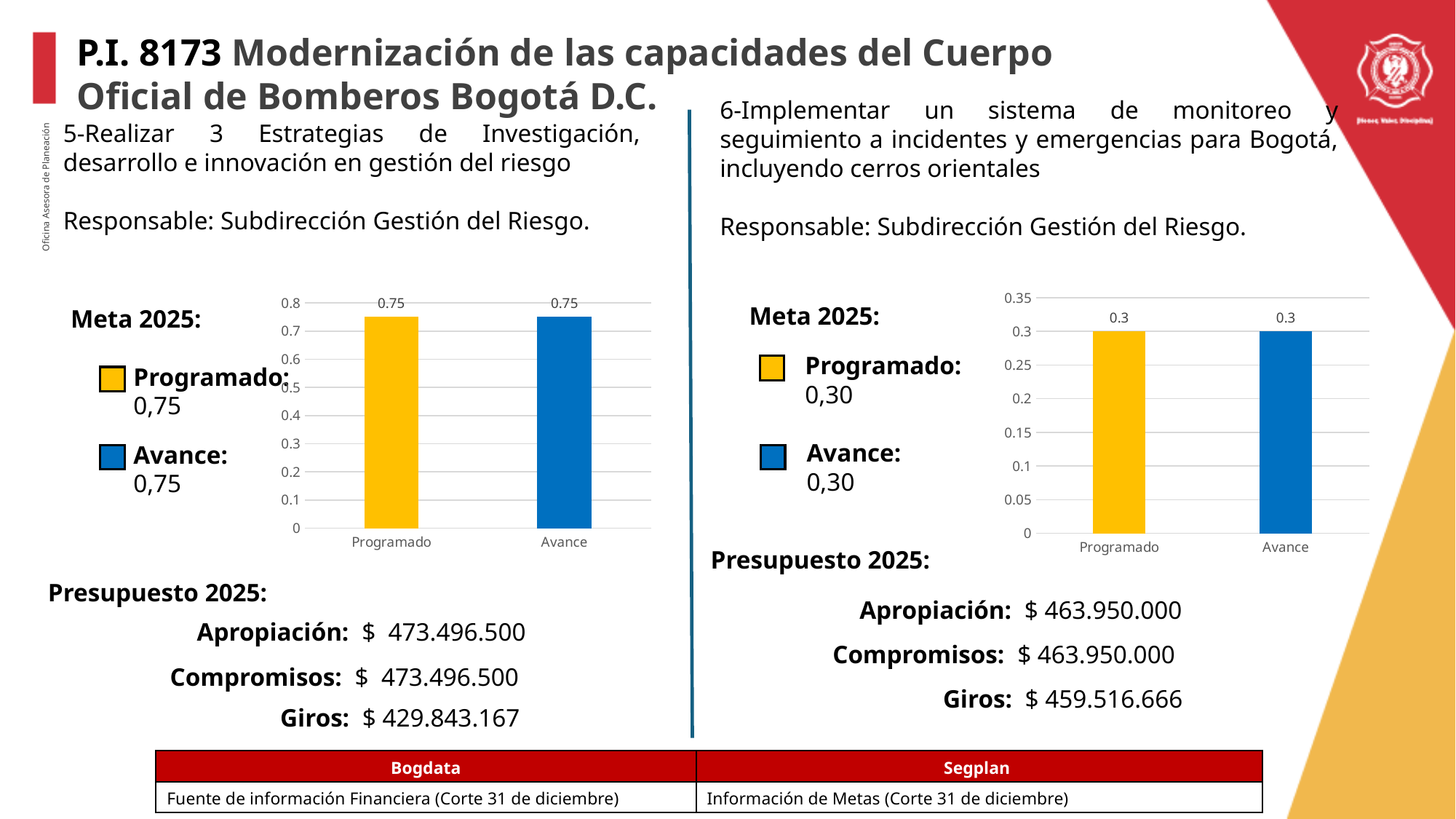
In the left chart, is the value for Programado greater or less than 0.5? greater In the right chart, is the value for Avance greater or less than 0.2? greater What kind of chart is the right chart? Bar chart In the right chart, what is the difference between the Programado and Avance values? 0 In the left chart, what colour is the Programado bar? Yellow In the left chart, what is the value for Programado? 0.75 In the right chart, what is the value for Programado? 0.3 In the left chart, what is the difference between the Programado and Avance values? 0 How many categories are shown in the left chart? 2 In the right chart, what is the value for Avance? 0.3 In the left chart, what is the value for Avance? 0.75 How many categories are shown in the right chart? 2